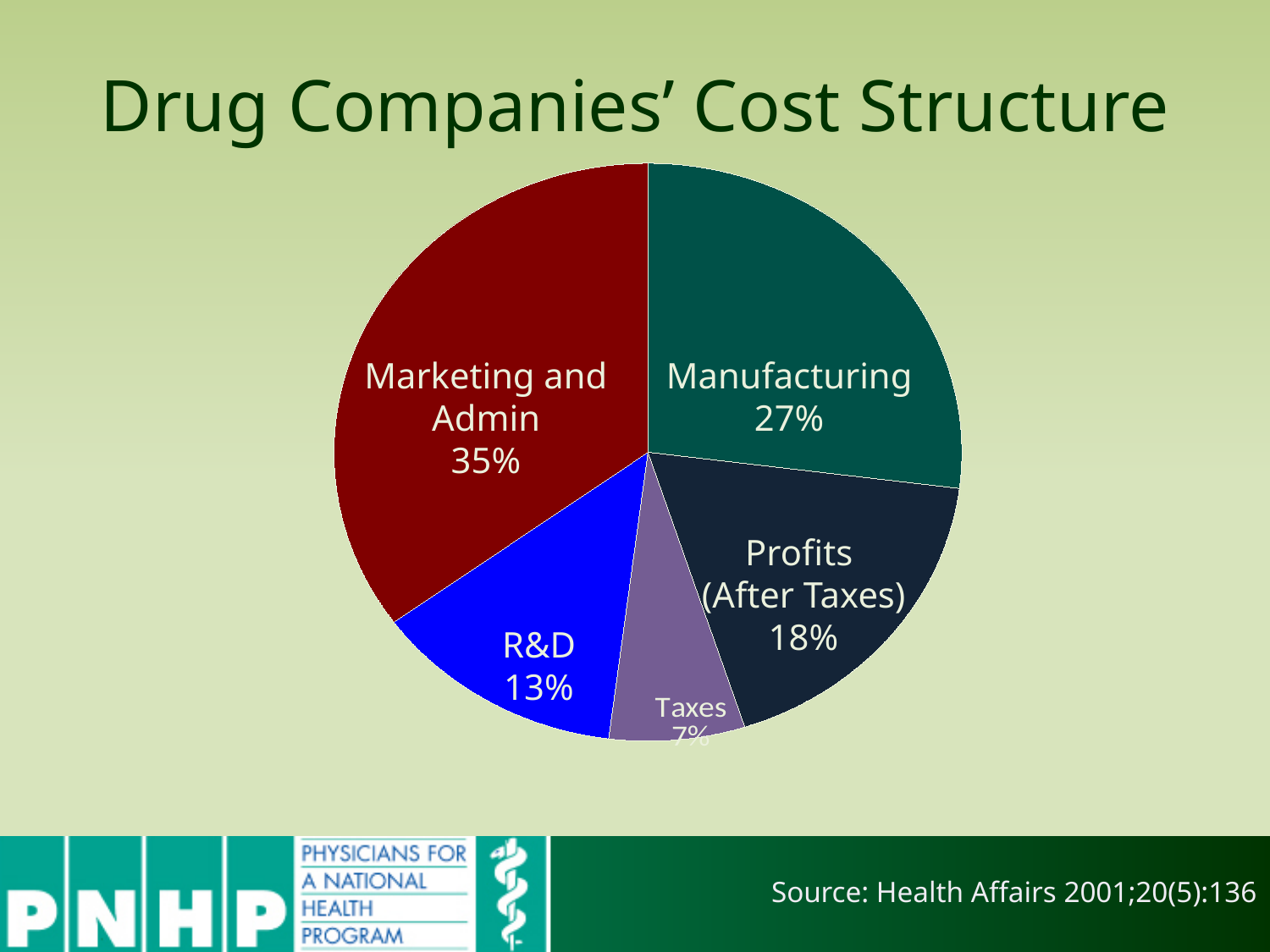
Which is larger, Manufacturing or Profits (After Taxes)? Manufacturing What share of the pie is Profits (After Taxes)? 18% What share of the pie is Marketing and Admin? 35% What kind of chart is shown on the slide? pie chart Which category has the smallest slice of the pie? Taxes Which category has the largest slice of the pie? Marketing and Admin What is the difference in percentage points between Marketing and Admin and R&D? 22 What colour is the R&D slice? blue How many slices does the pie chart have? 5 What share of the pie is Manufacturing? 27% What share of the pie is R&D? 13% What is the title of the chart? Drug Companies' Cost Structure